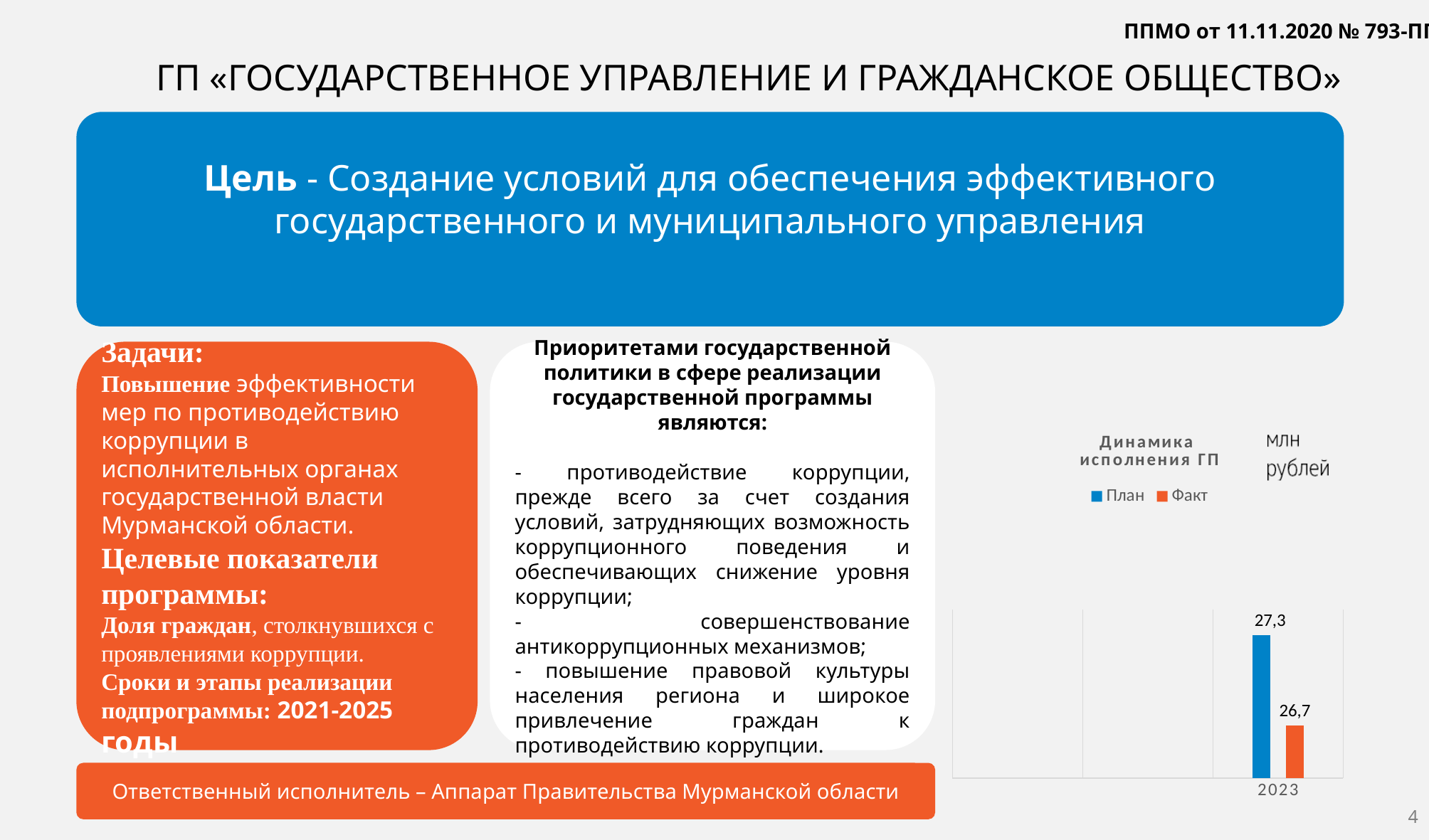
How many years (categories) are shown on the x axis of the chart 'Динамика исполнения ГП'? 1 What is the value of Факт (actual) for 2023 in the chart 'Динамика исполнения ГП'? 26,7 Which series is the highest for 2023 in the chart 'Динамика исполнения ГП'? План Which year is shown on the x axis of the chart 'Динамика исполнения ГП'? 2023 Which series has the higher value for 2023 in the chart 'Динамика исполнения ГП', План or Факт? План What is the value of План (plan) for 2023 in the chart 'Динамика исполнения ГП'? 27,3 What unit is indicated next to the chart 'Динамика исполнения ГП'? млн рублей How many series does the legend of the chart 'Динамика исполнения ГП' list? 2 What kind of chart is 'Динамика исполнения ГП'? Bar chart What is the difference between the План and Факт values for 2023 in the chart 'Динамика исполнения ГП'? 0,6 Which series is the lowest for 2023 in the chart 'Динамика исполнения ГП'? Факт